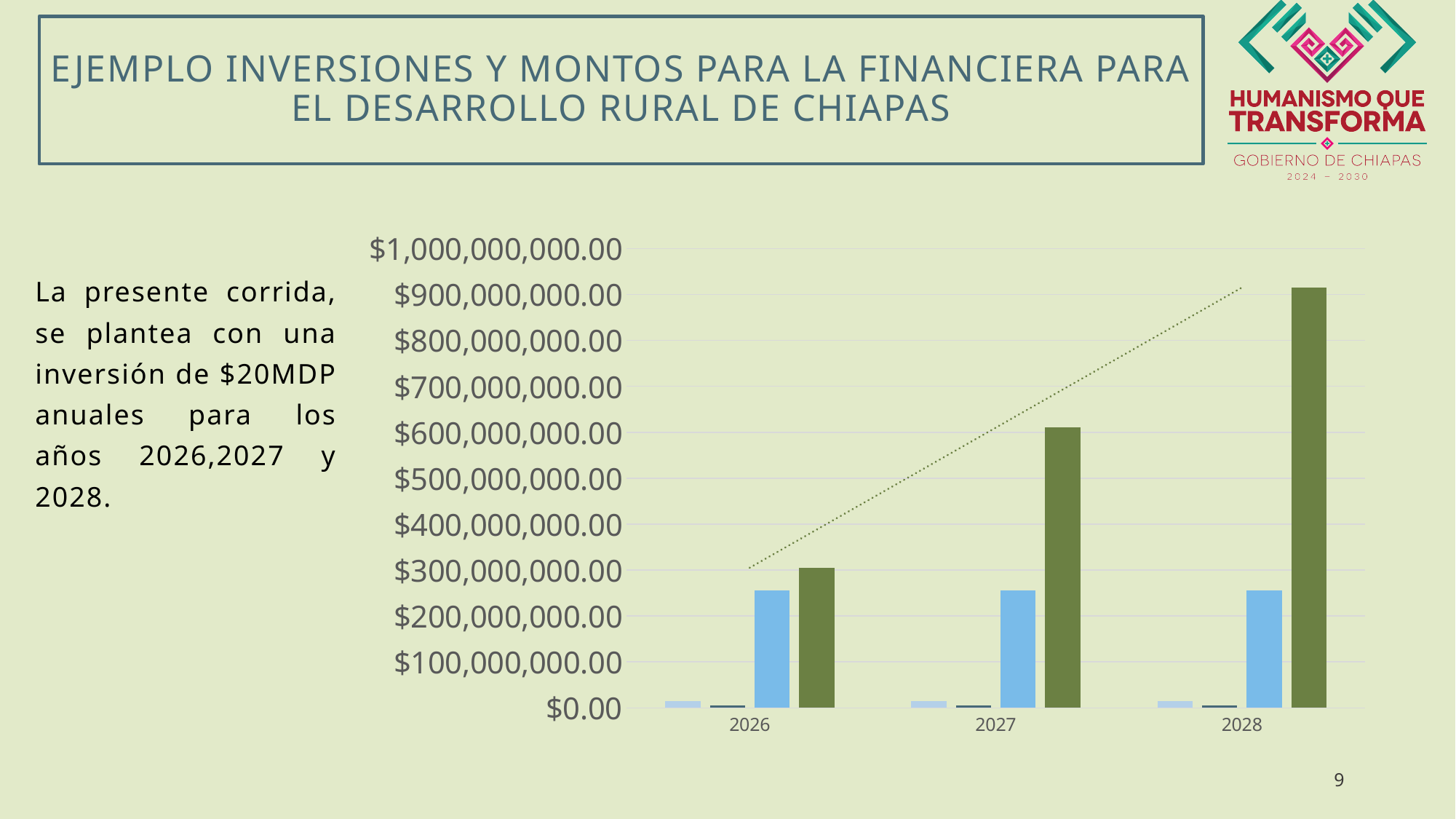
Is the dark green bar for 2026 greater or less than $400,000,000.00? less How many years are shown on the x axis of the chart? 3 In 2028, which is larger, the blue bar or the dark green bar? the dark green bar Which is larger, the dark green bar for 2027 or the dark green bar for 2026? 2027 What is the highest value labelled on the y axis of the chart? $1,000,000,000.00 Is the dark green bar for 2028 greater or less than $800,000,000.00? greater Which year has the tallest dark green bar? 2028 Which year has the shortest dark green bar? 2026 Do the dark green bars rise or fall from 2026 to 2028? rise Is the dark green bar for 2027 greater or less than $500,000,000.00? greater What kind of chart is shown on the slide? bar chart